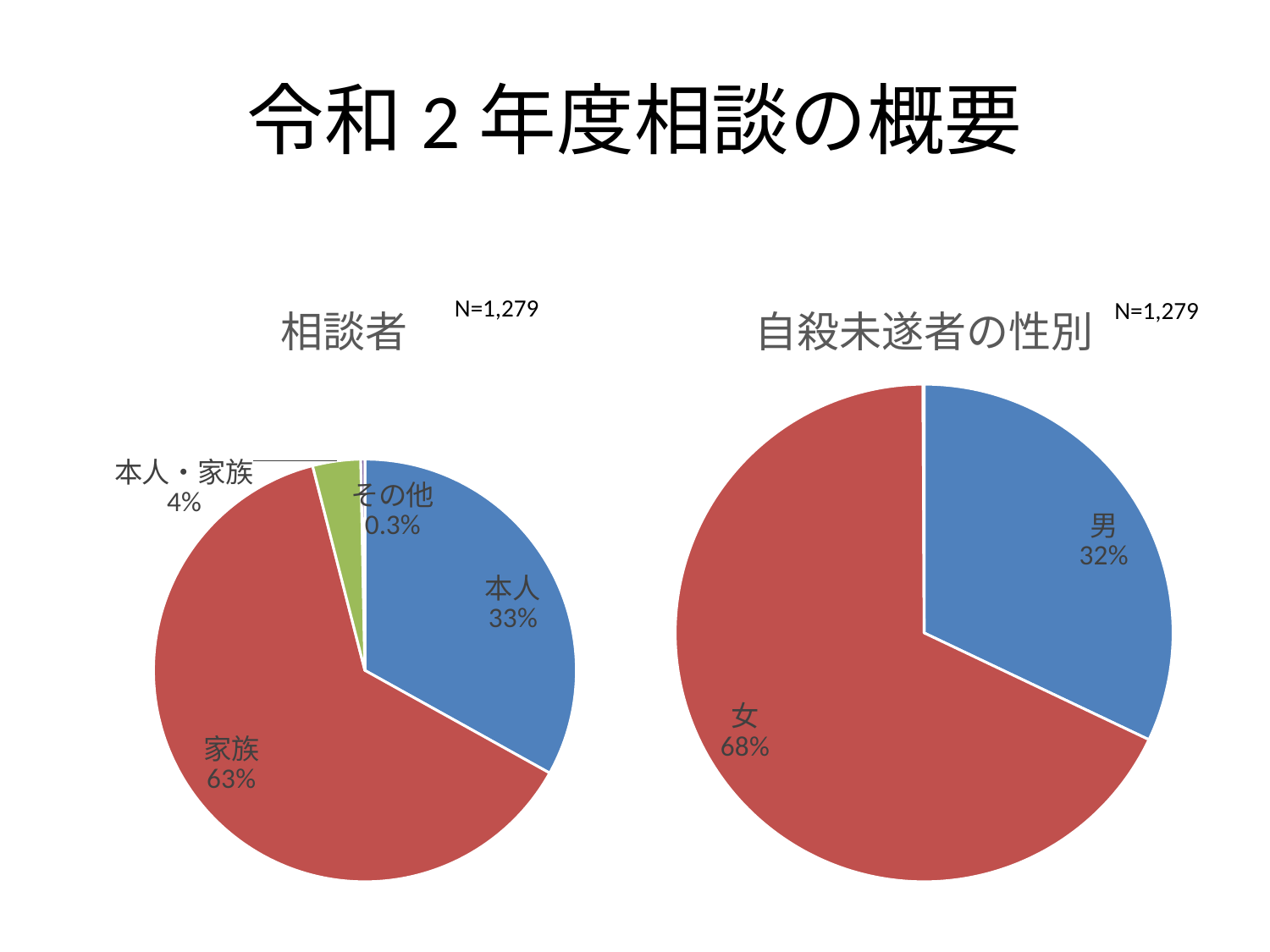
In the 自殺未遂者の性別 pie chart, what share does 男 have? 32% In the 相談者 pie chart, which category has the largest share? 家族 In the 相談者 pie chart, what share does 本人 have? 33% In the 自殺未遂者の性別 pie chart, what share does 女 have? 68% In the 相談者 pie chart, what share does その他 have? 0.3% In the 自殺未遂者の性別 pie chart, which is larger, 男 or 女? 女 In the 相談者 pie chart, which category has the smallest share? その他 In the 相談者 pie chart, what share does 本人・家族 have? 4% In the 相談者 pie chart, how many slices are there? 4 What type of chart is the 自殺未遂者の性別 chart? Pie chart In the 相談者 pie chart, what is the difference in percentage points between 家族 and 本人? 30 In the 相談者 pie chart, what share does 家族 have? 63%